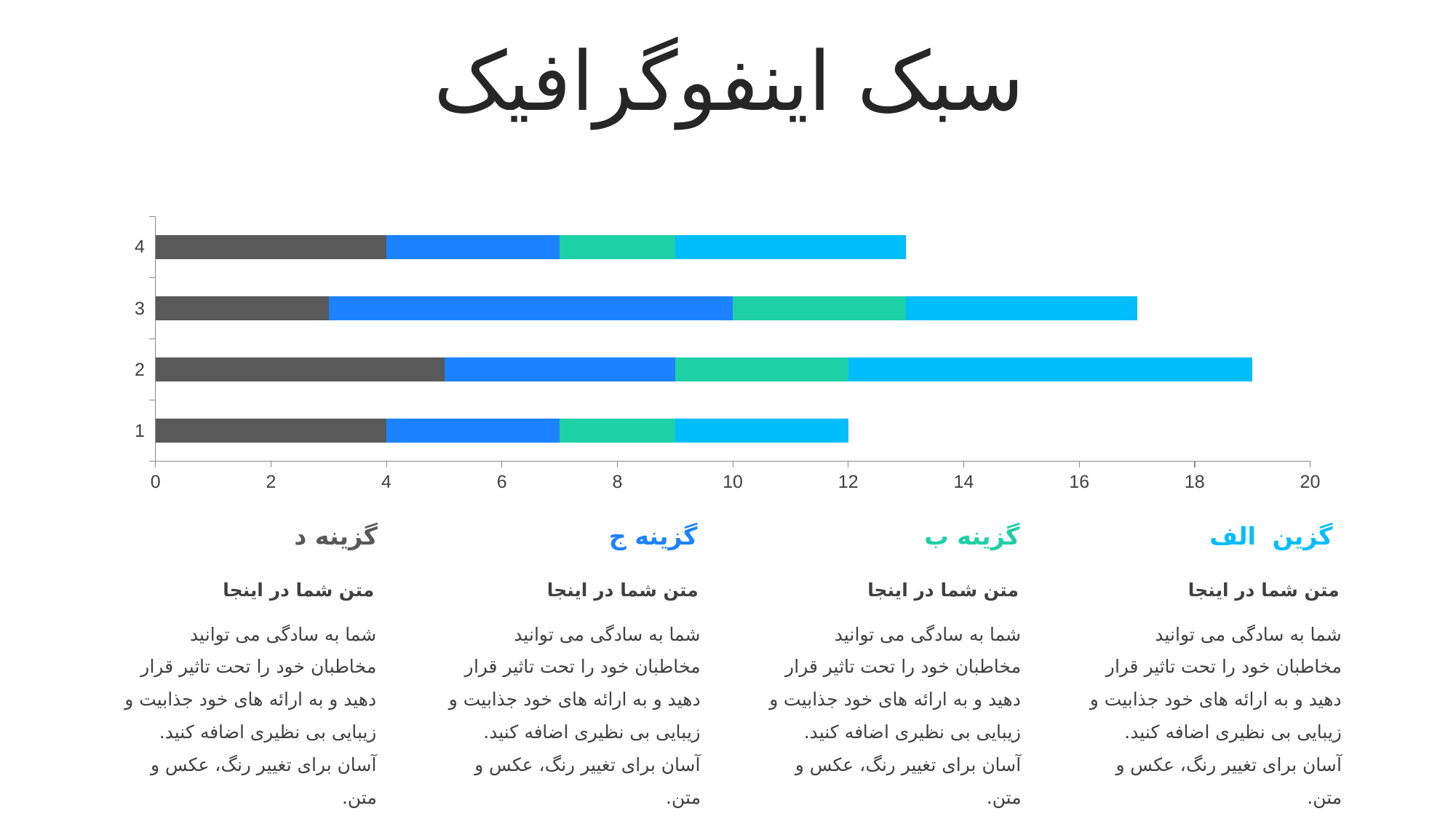
What is the maximum value shown on the horizontal axis of the chart? 20 What is the total length of the stacked bar for category 1? 12 Is the total of the stacked bar for category 3 greater or less than 16? greater Which category has the longest stacked bar overall? 2 Which stacked bar is longer overall, category 3 or category 4? 3 How many coloured series are stacked in each bar of the chart? 4 What is the value of the dark grey segment (گزینه د) for category 1? 4 What is the value of the dark grey segment (گزینه د) for category 4? 4 What kind of chart is shown on the slide? stacked bar chart How many categories are shown on the vertical axis of the chart? 4 Is the total of the stacked bar for category 2 greater or less than 18? greater Is the total of the stacked bar for category 4 greater or less than 14? less